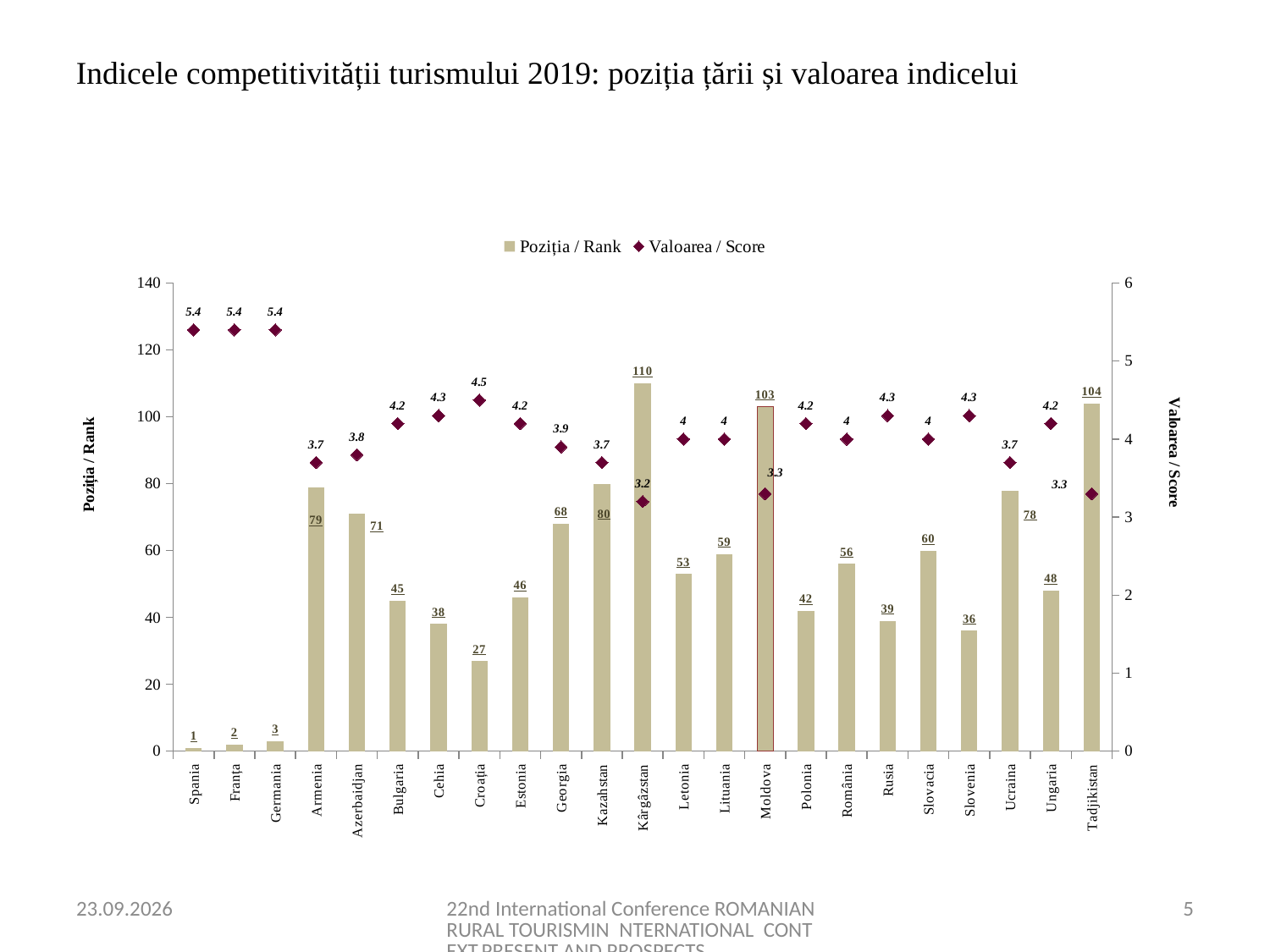
What is the difference between the Poziția / Rank values of Tadjikistan and Moldova? 1 What kind of chart is used for the Poziția / Rank series? bar chart What is the Poziția / Rank value for Moldova? 103 Which has a higher Poziția / Rank value, Armenia or Azerbaidjan? Armenia Which country has the lowest Valoarea / Score? Kârgâzstan How many series does the legend list? 2 Which country has the highest Poziția / Rank bar? Kârgâzstan What is the Poziția / Rank value for Kazahstan? 80 How many countries are shown on the x axis? 23 What is the Valoarea / Score value for Spania? 5.4 What is the Valoarea / Score value for Croația? 4.5 Is the Poziția / Rank value for Kârgâzstan greater or less than 100? greater